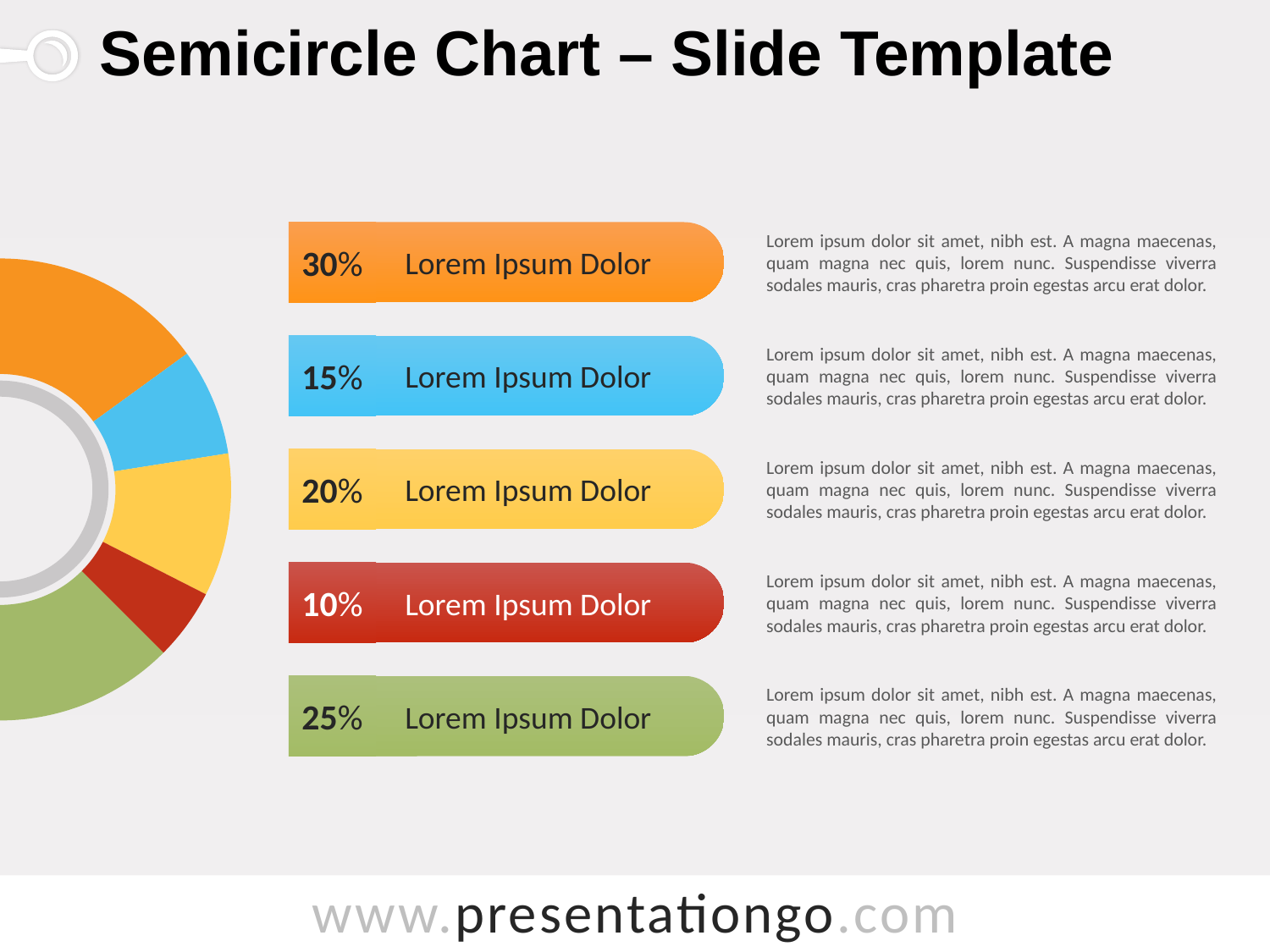
What percentage is shown for the red segment? 10% What is the total of all five percentages shown? 100% What percentage is shown for the orange segment? 30% What kind of chart is shown on the slide? Semicircle (half-donut) chart How many segments does the semicircle chart have? 5 What percentage is shown for the yellow segment? 20% Which is larger, the green segment or the yellow segment? Green (25%) What percentage is shown for the blue segment? 15% What is the difference between the orange segment's percentage and the red segment's percentage? 20% What percentage is shown for the green segment? 25% Which colour segment has the smallest percentage? Red (10%) Which colour segment has the largest percentage? Orange (30%)